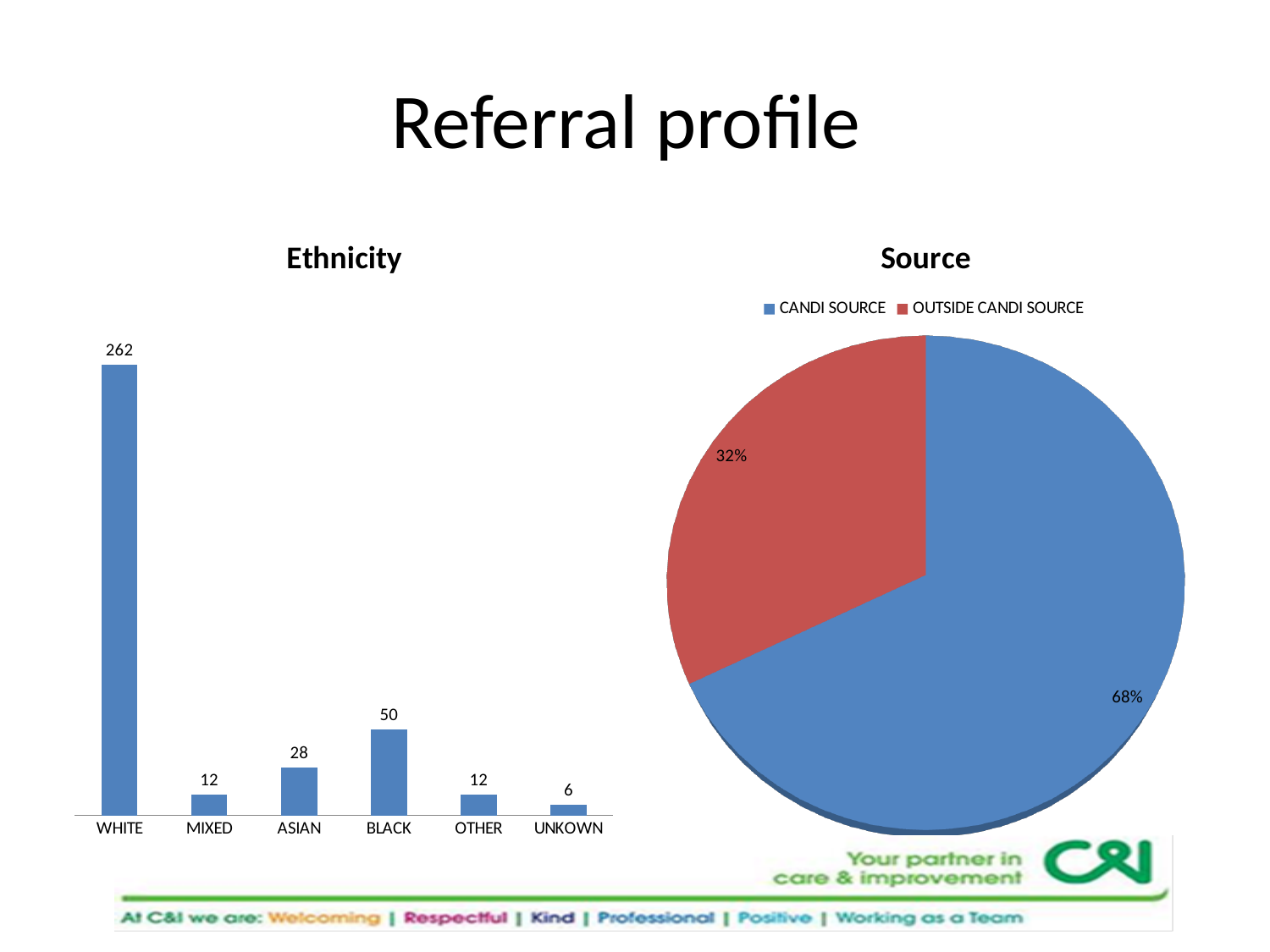
In the Source chart, what share of the pie is CANDI SOURCE? 68% In the Ethnicity chart, what is the value for BLACK? 50 In the Ethnicity chart, what is the value for ASIAN? 28 In the Ethnicity chart, what is the value for WHITE? 262 In the Ethnicity chart, which category has the lowest value? UNKOWN In the Ethnicity chart, which is larger, the value for MIXED or the value for ASIAN? ASIAN In the Ethnicity chart, which category has the highest value? WHITE How many categories are shown in the Ethnicity chart? 6 In the Source chart, what share of the pie is OUTSIDE CANDI SOURCE? 32% How many entries does the legend of the Source chart list? 2 What kind of chart is the Ethnicity chart? Bar chart In the Ethnicity chart, what is the difference between the values for BLACK and ASIAN? 22